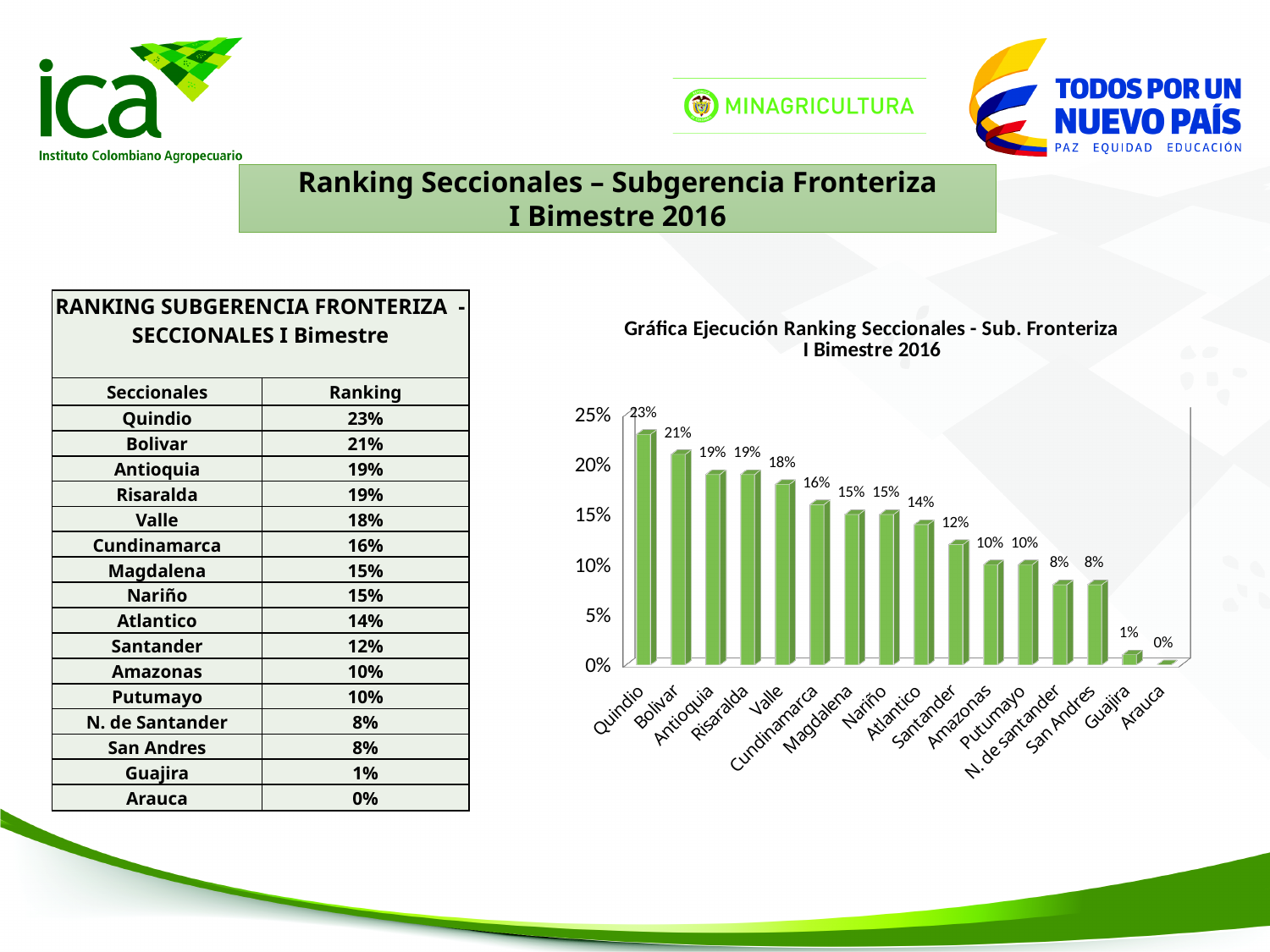
How many categories are shown on the x axis of the chart? 16 Which category has the lowest value in the chart? Arauca What is the value for Quindio in the chart? 23% What kind of chart is shown on the slide? bar chart What is the difference between the values for Santander and San Andres? 4% Which category has the highest value in the chart? Quindio Which is larger, the value for Valle or the value for Atlantico? Valle What is the difference between the values for Quindio and Bolivar? 2% Do the values rise or fall from left to right along the x axis? fall What is the value for Guajira in the chart? 1% What is the value for Cundinamarca in the chart? 16% Is the value for Amazonas greater or less than 15%? less